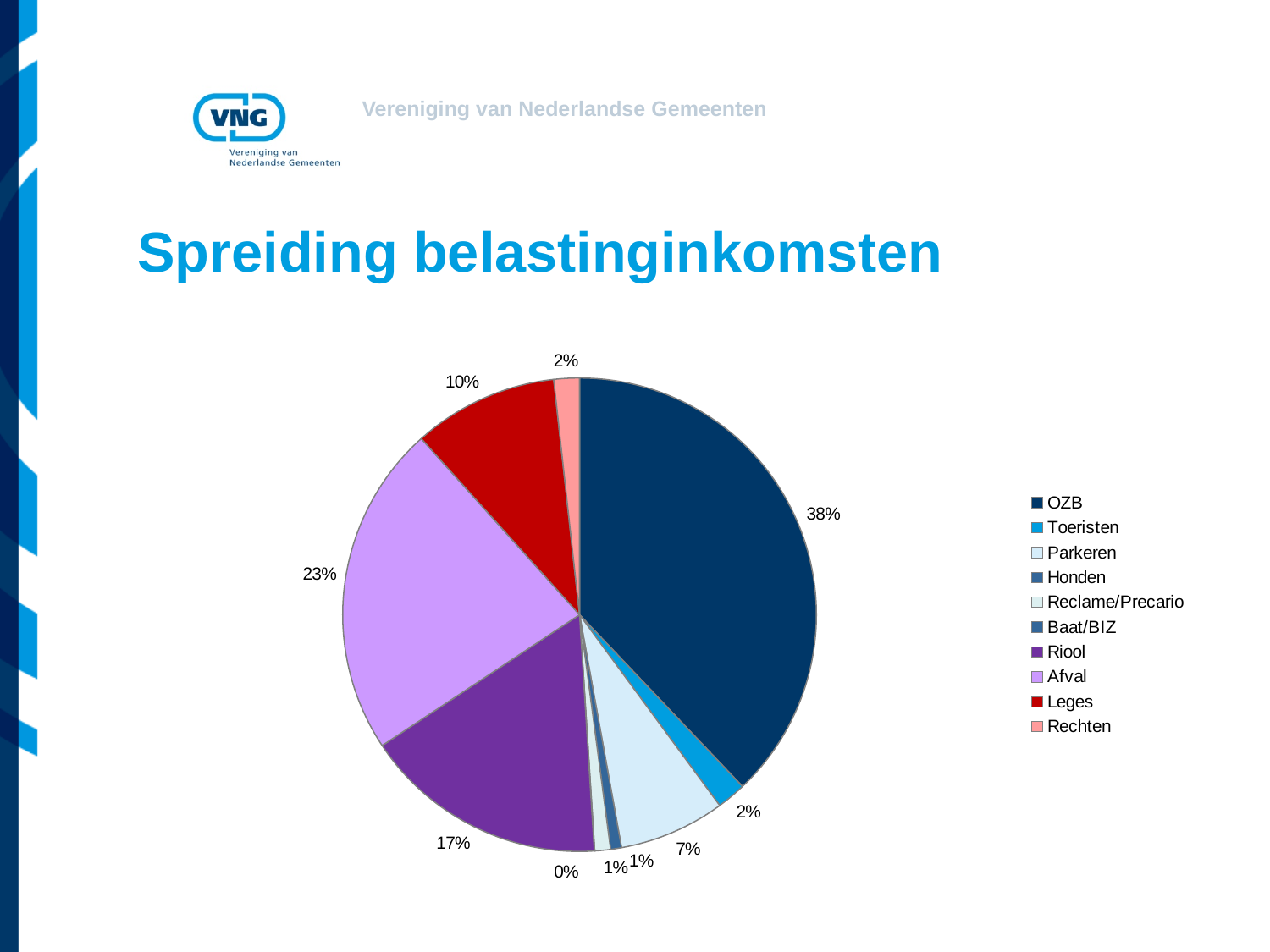
What percentage of the pie is OZB? 38% How many categories does the legend of the pie chart list? 10 Which category has the largest share of the pie? OZB What is the title of the slide containing the chart? Spreiding belastinginkomsten What percentage is shown for Parkeren? 7% What type of chart is shown on the slide? pie chart Which has a larger share, Riool or Leges? Riool What percentage is shown for Riool? 17% What percentage is shown for Leges? 10% Which category has the smallest share of the pie? Baat/BIZ What share of the pie does Afval take? 23% What is the difference in percentage points between OZB and Afval? 15